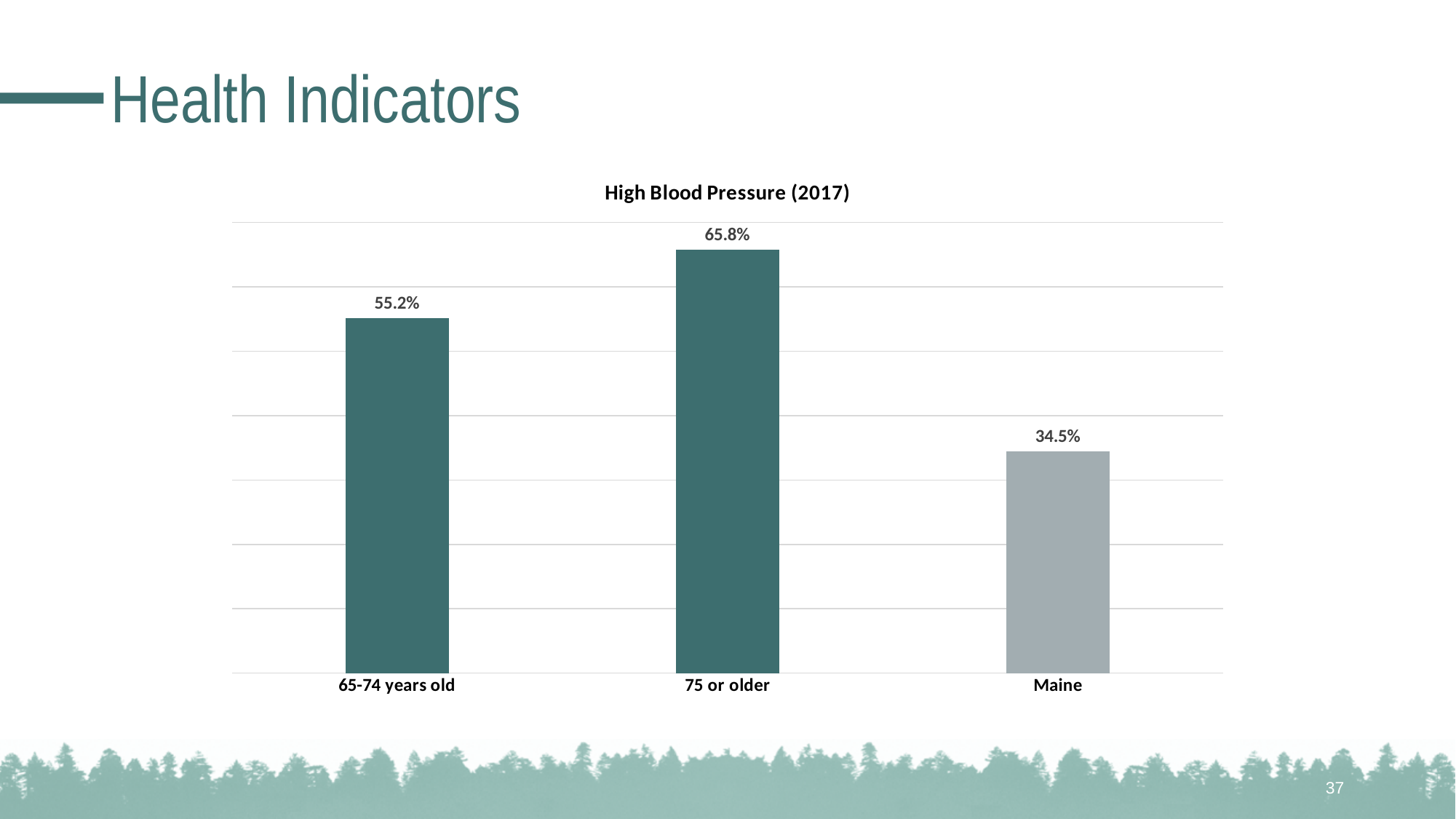
Which bar is shown in a different (grey) colour from the others? Maine Which category has the highest value? 75 or older What is the title of the chart? High Blood Pressure (2017) Which category has the lowest value? Maine What is the value for Maine? 34.5% What is the value for 65-74 years old? 55.2% What is the value for 75 or older? 65.8% Which is larger, the value for 65-74 years old or the value for Maine? 65-74 years old How many categories are shown in the chart? 3 What is the difference between the values for 75 or older and 65-74 years old? 10.6% What kind of chart is shown on the slide? Bar chart What is the difference between the values for 65-74 years old and Maine? 20.7%